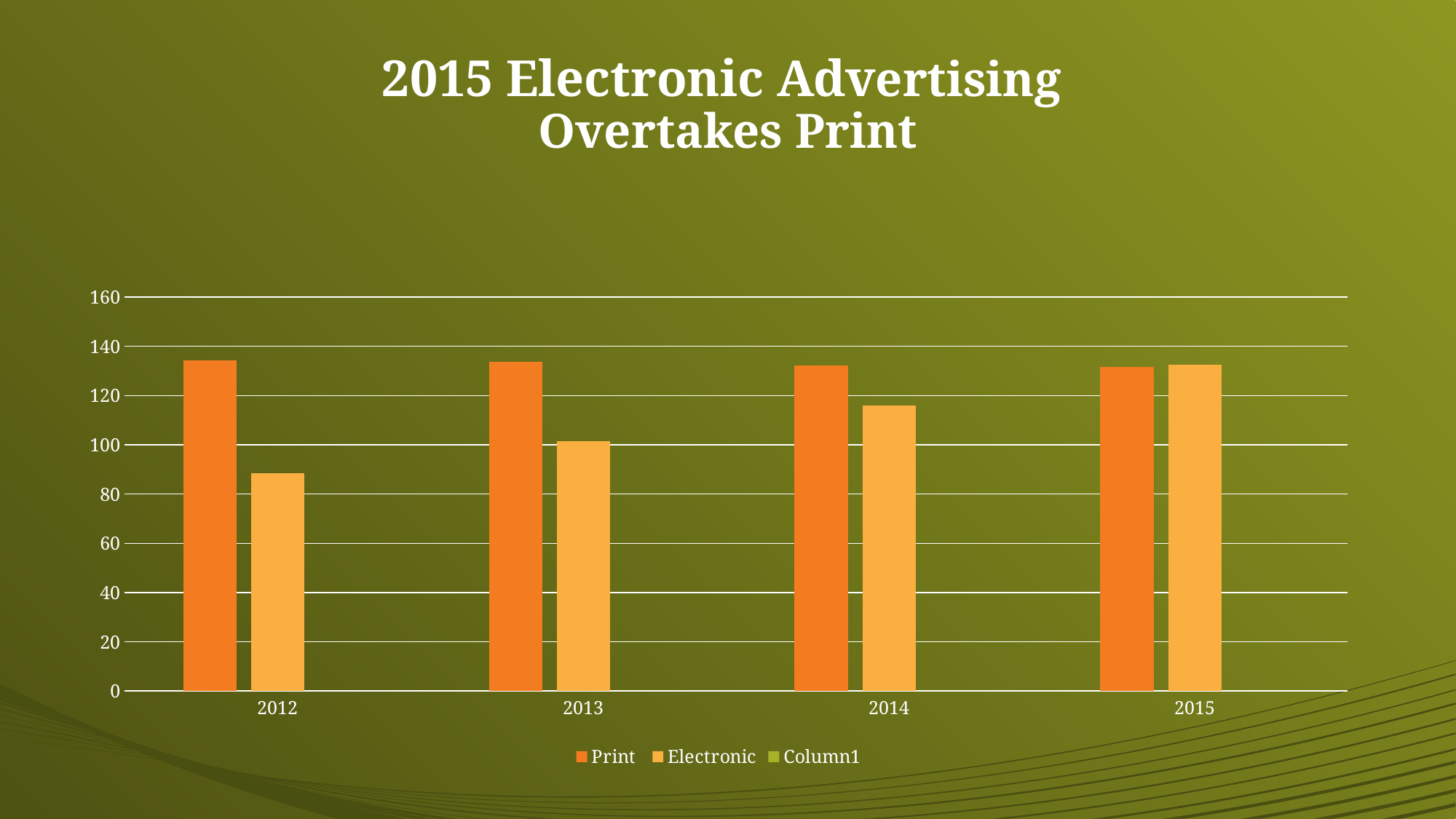
In which year is the Electronic value highest? 2015 What kind of chart is shown on the slide? bar chart In which year is the Electronic value lowest? 2012 In 2014, which is larger, Print or Electronic? Print How many series does the chart's legend list? 3 What is the title of the chart? 2015 Electronic Advertising Overtakes Print Is the Electronic value for 2012 greater or less than 100? less Is the Print value for 2013 greater or less than 120? greater How many years are shown on the x axis of the chart? 4 In 2012, which is larger, Print or Electronic? Print Which series does the legend list first? Print Do the Electronic values rise or fall from 2012 to 2015? rise